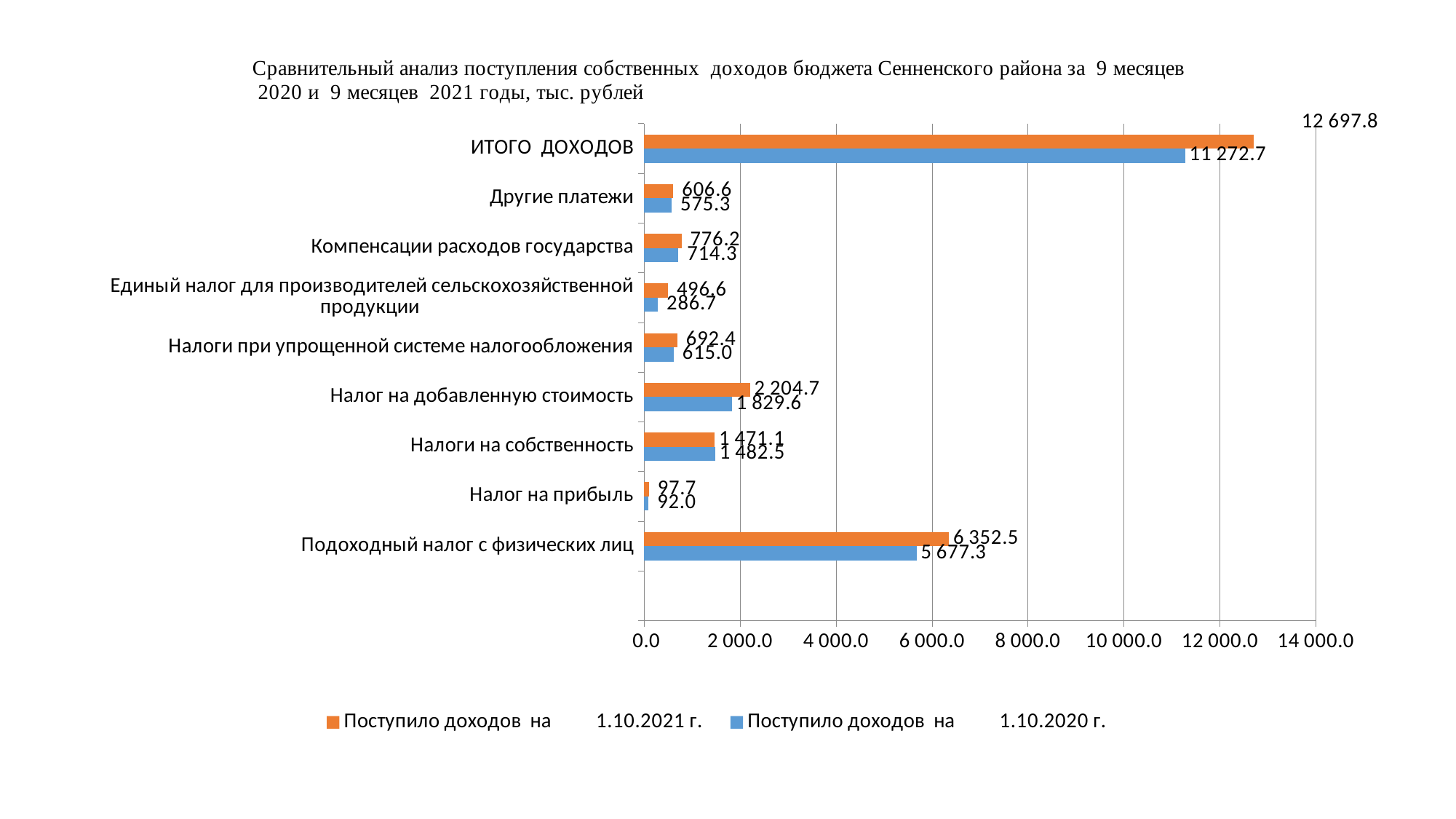
How many series does the legend list? 2 What type of chart is shown on the slide? bar chart Excluding ИТОГО ДОХОДОВ, which category has the highest value for Поступило доходов на 1.10.2021 г.? Подоходный налог с физических лиц What is the difference between the ИТОГО ДОХОДОВ values for 1.10.2021 г. and 1.10.2020 г.? 1 425.1 What is the value of Единый налог для производителей сельскохозяйственной продукции for Поступило доходов на 1.10.2020 г.? 286.7 How many categories are shown on the vertical axis of the chart? 9 What is the value of ИТОГО ДОХОДОВ for Поступило доходов на 1.10.2021 г.? 12 697.8 Is the value of Подоходный налог с физических лиц for 1.10.2021 г. greater or less than 6 000.0? greater For Налоги на собственность, which series has the larger value: Поступило доходов на 1.10.2021 г. or Поступило доходов на 1.10.2020 г.? Поступило доходов на 1.10.2020 г. Which category has the lowest value for Поступило доходов на 1.10.2020 г.? Налог на прибыль What is the value of Налог на добавленную стоимость for Поступило доходов на 1.10.2021 г.? 2 204.7 What is the value of Подоходный налог с физических лиц for Поступило доходов на 1.10.2020 г.? 5 677.3